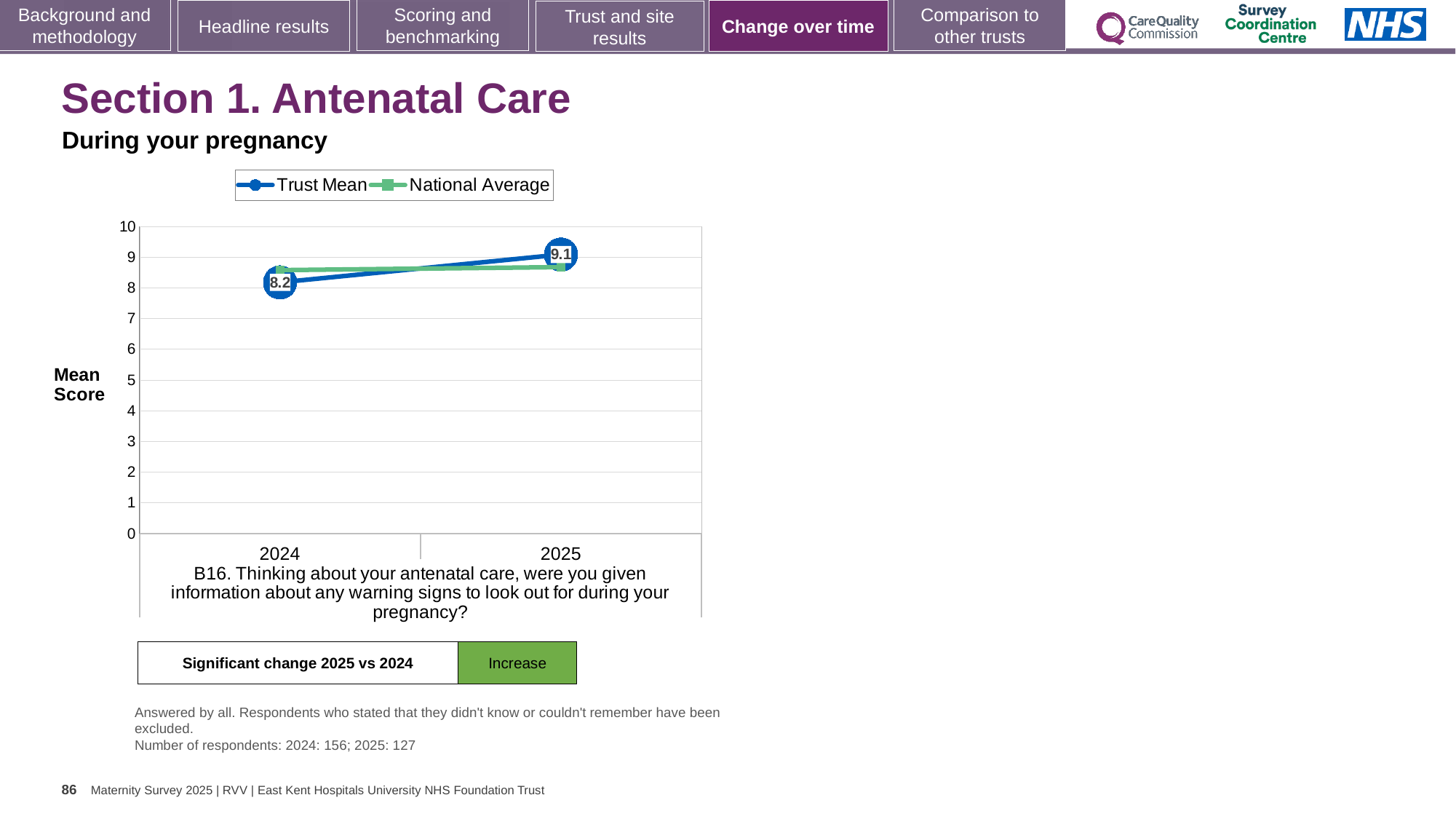
What does the box below the chart say about the significant change 2025 vs 2024? Increase What is the Trust Mean score for 2024? 8.2 Is the National Average for 2024 greater or less than 8? greater By how much did the Trust Mean change from 2024 to 2025? 0.9 What kind of chart is shown on the slide? line chart In 2025, which is larger, the Trust Mean or the National Average? Trust Mean In which year is the Trust Mean highest? 2025 In 2024, which is larger, the Trust Mean or the National Average? National Average What is the Trust Mean score for 2025? 9.1 Does the Trust Mean rise or fall from 2024 to 2025? rise In which year is the Trust Mean lowest? 2024 How many series does the legend list? 2